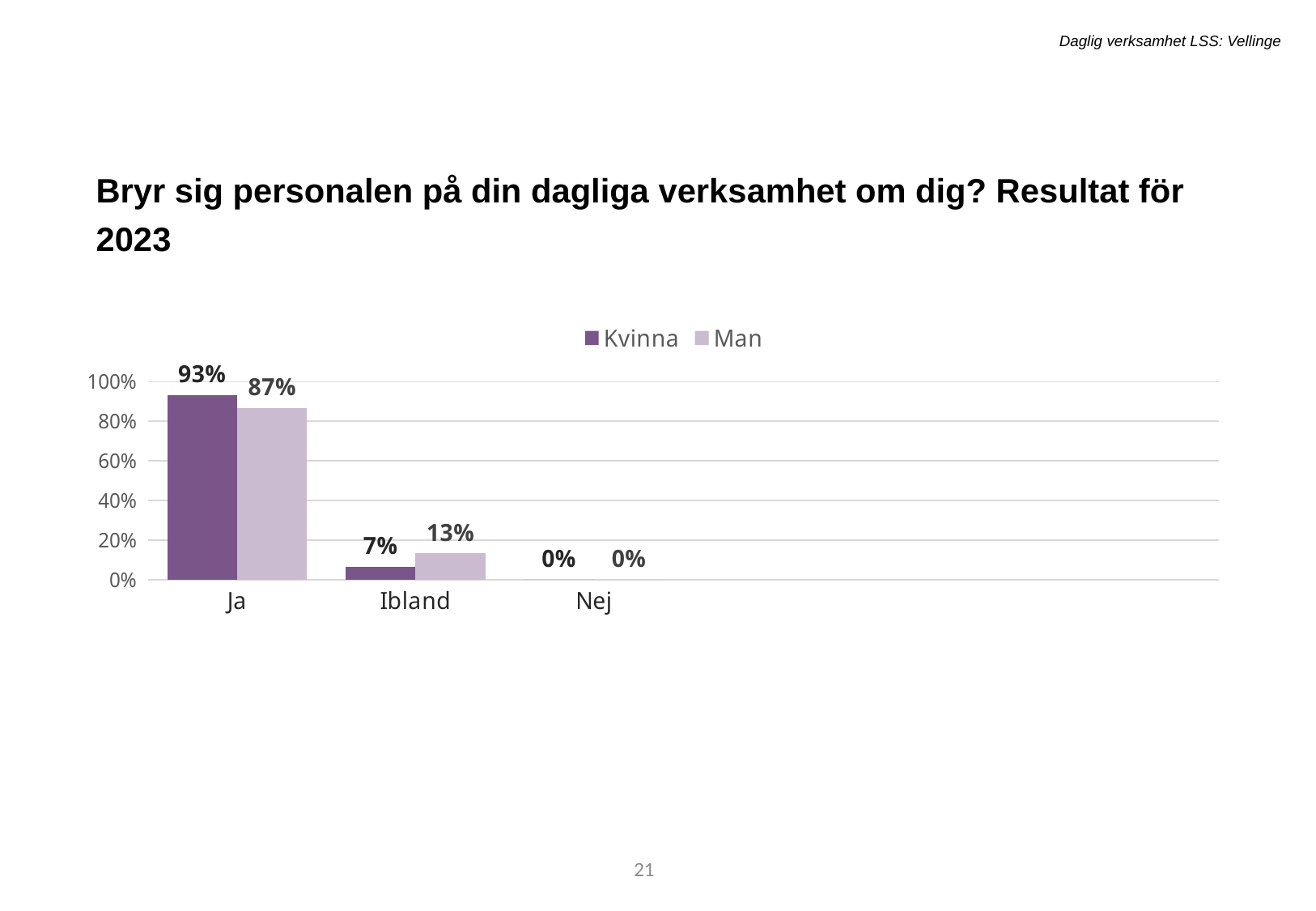
What is the difference between the Kvinna and Man values in the Ja category? 6% What kind of chart is shown on the slide? Bar chart What is the value for Man in the Nej category? 0% What is the value for Kvinna in the Ja category? 93% How many series does the legend list? 2 In the Ibland category, which series has the larger value, Kvinna or Man? Man What is the value for Man in the Ja category? 87% How many categories are shown on the x axis? 3 What is the value for Man in the Ibland category? 13% Which category has the highest value for Kvinna? Ja What is the value for Kvinna in the Ibland category? 7% Which category has the lowest value for Man? Nej